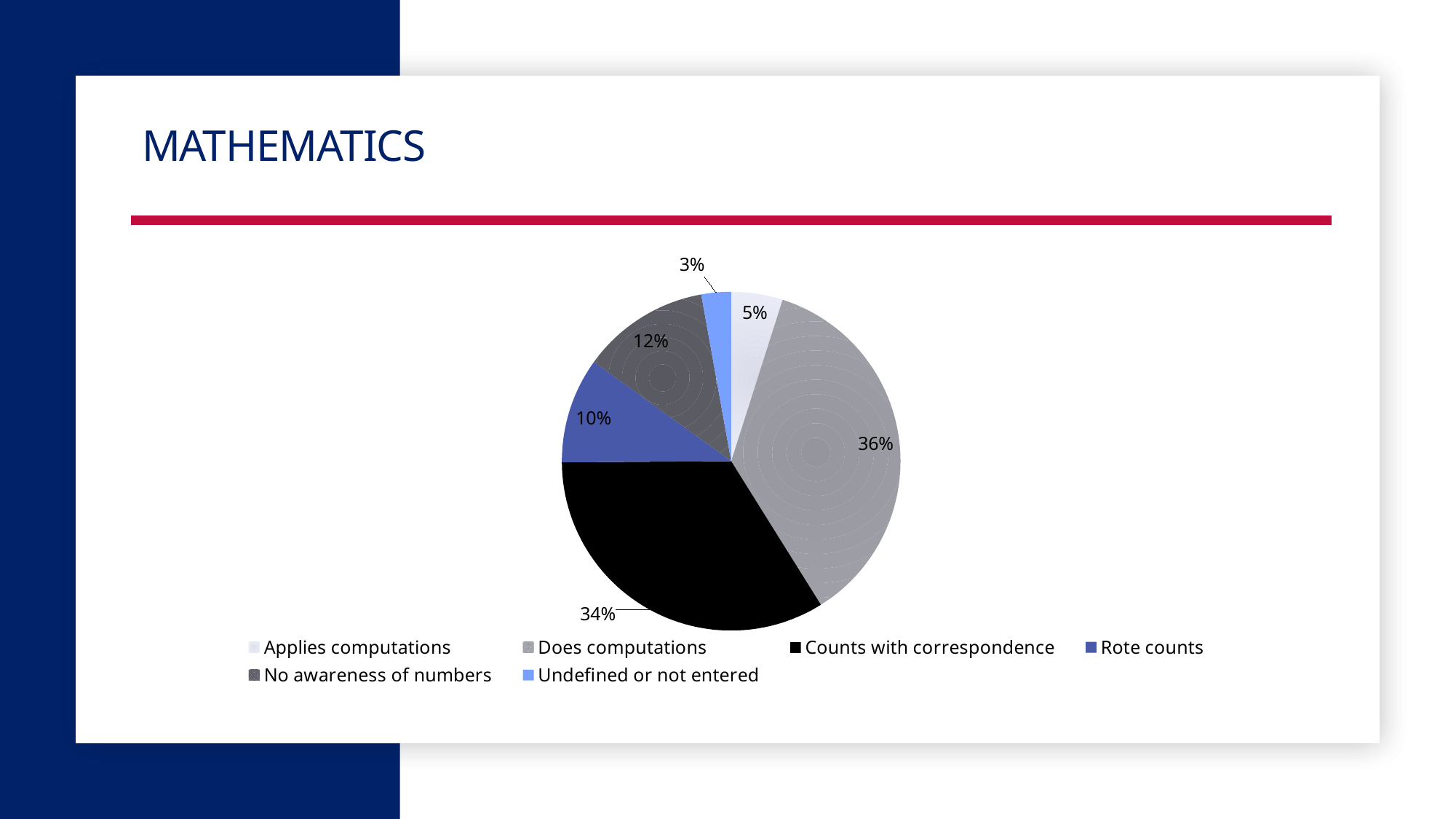
Which category has the largest share of the pie? Does computations What type of chart is shown on the slide? Pie chart What is the difference in percentage points between Does computations and Counts with correspondence? 2 What percentage of the pie is No awareness of numbers? 12% What percentage of the pie is Rote counts? 10% What is the title of the slide containing the chart? MATHEMATICS What percentage of the pie is Applies computations? 5% What percentage of the pie is Counts with correspondence? 34% How many categories does the pie chart have? 6 Which is larger, No awareness of numbers or Rote counts? No awareness of numbers Which category has the smallest share of the pie? Undefined or not entered What percentage of the pie is Does computations? 36%